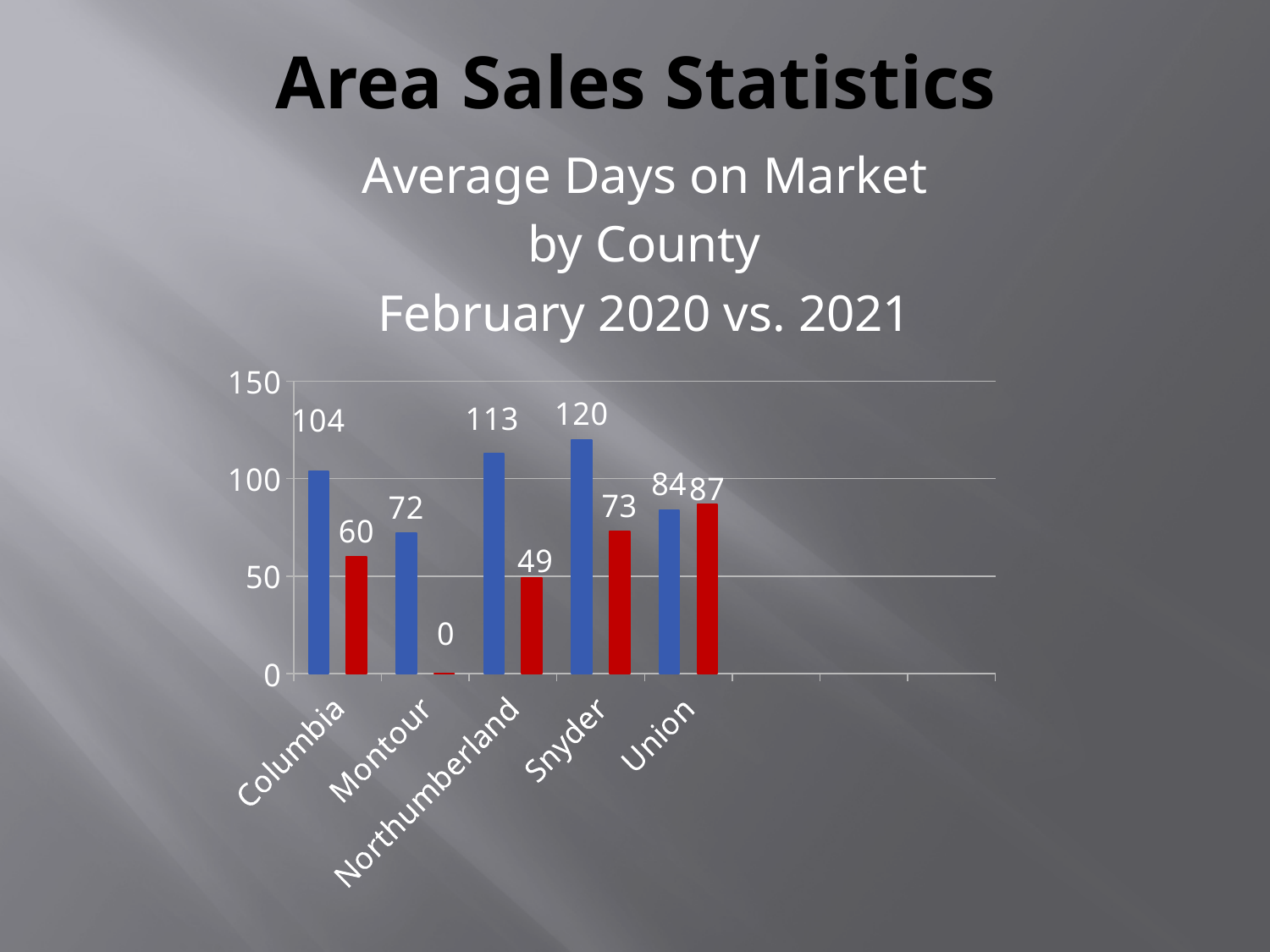
What is the difference between the blue bar and the red bar for Columbia? 44 Which county has the highest red bar? Union What is the value of the blue bar for Union? 84 What is the difference between the blue bar and the red bar for Snyder? 47 Which county has the lowest red bar? Montour Which county has the highest blue bar? Snyder What is the value of the red bar for Northumberland? 49 For Union, which is larger, the blue bar or the red bar? The red bar What kind of chart is shown on the slide? Bar chart What is the value of the red bar for Montour? 0 How many counties are shown on the x axis of the chart? 5 What is the value of the blue bar for Columbia? 104